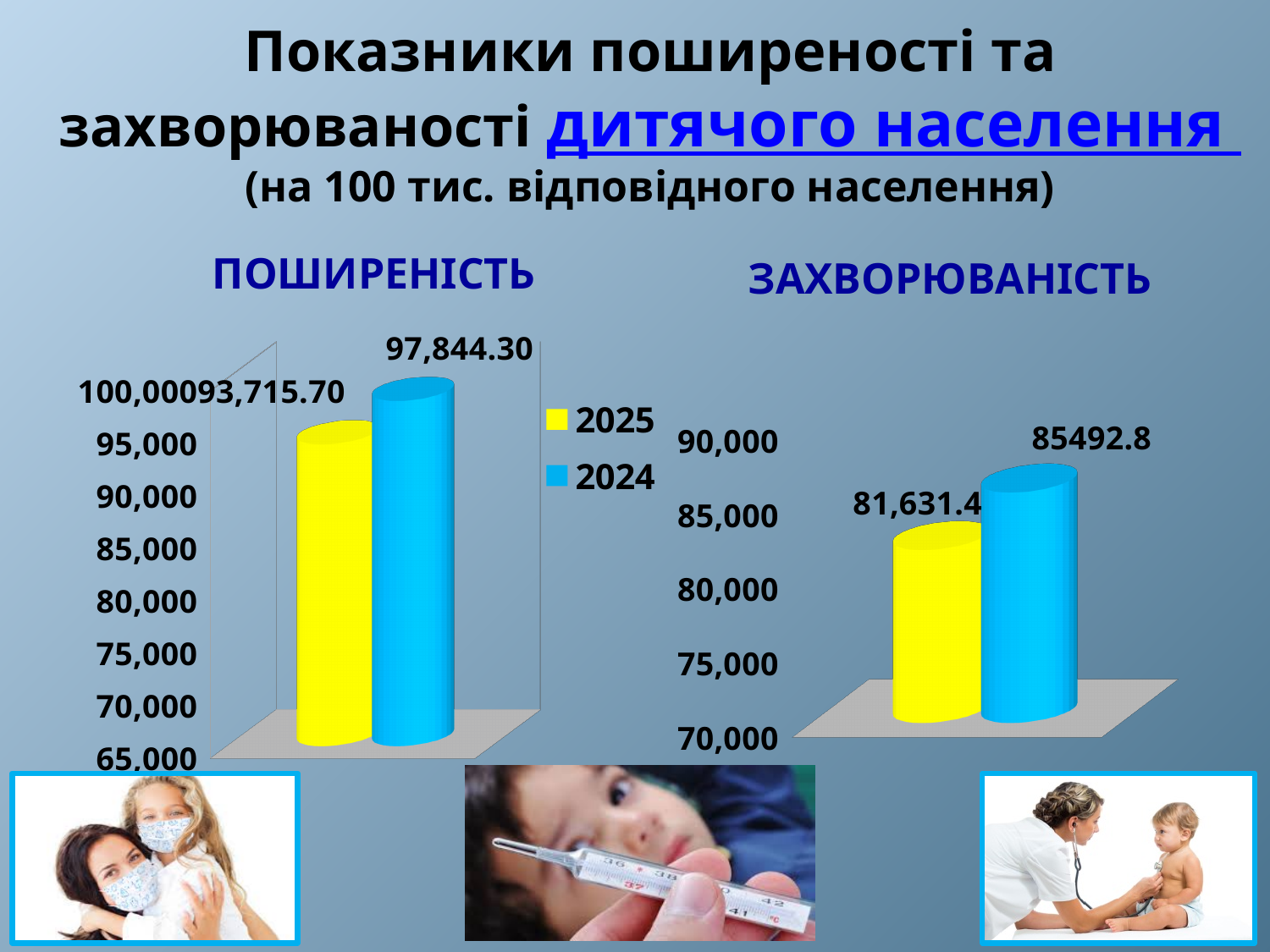
In the ПОШИРЕНІСТЬ chart, what is the difference between the 2024 and 2025 values? 4,128.60 In the ЗАХВОРЮВАНІСТЬ chart, which bar is lower, the yellow one or the blue one? the yellow one In the ПОШИРЕНІСТЬ chart, what is the value for 2025? 93,715.70 In the ПОШИРЕНІСТЬ chart, what is the value for 2024? 97,844.30 What kind of chart is the ЗАХВОРЮВАНІСТЬ chart? bar chart In the ЗАХВОРЮВАНІСТЬ chart, what value is shown on the blue bar? 85492.8 In the ПОШИРЕНІСТЬ chart, is the value for 2025 greater or less than 90,000? greater In the ЗАХВОРЮВАНІСТЬ chart, is the value of the yellow bar greater or less than 80,000? greater In the ПОШИРЕНІСТЬ chart, which year has the higher value? 2024 How many series does the legend on the slide list? 2 In the ЗАХВОРЮВАНІСТЬ chart, what is the difference between the blue bar and the yellow bar? 3,861.4 In the ЗАХВОРЮВАНІСТЬ chart, what value is shown on the yellow bar? 81,631.4